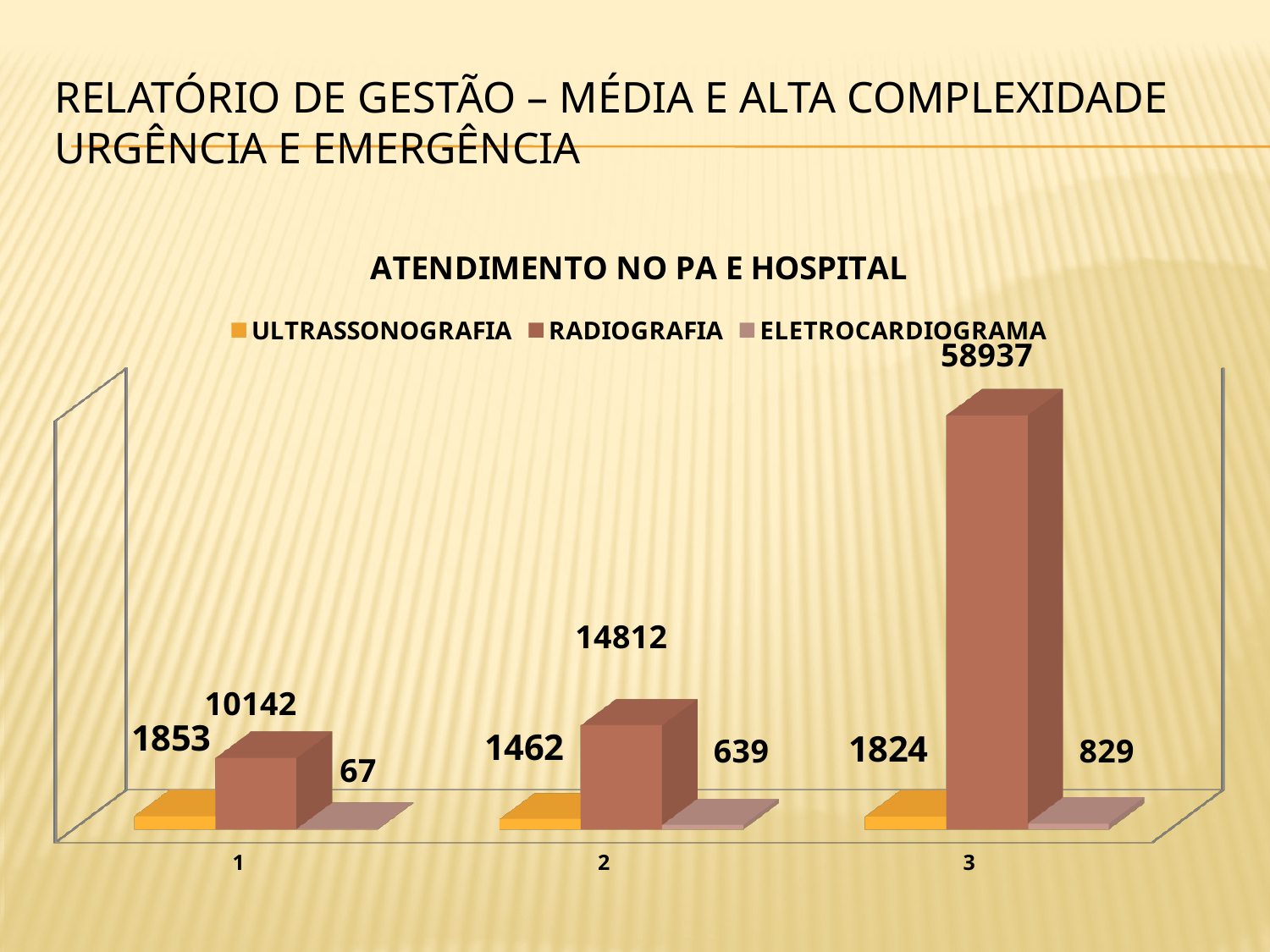
Which category has the lowest ELETROCARDIOGRAMA value? 1 What is the value of RADIOGRAFIA for category 3? 58937 What kind of chart is shown? Bar chart Which category has the highest RADIOGRAFIA value? 3 What is the title of the chart? ATENDIMENTO NO PA E HOSPITAL How many series does the legend list? 3 Do the RADIOGRAFIA values rise or fall from category 1 to category 3? Rise How many categories are shown on the x axis? 3 Which is larger, ULTRASSONOGRAFIA for category 1 or ULTRASSONOGRAFIA for category 3? Category 1 What is the value of ELETROCARDIOGRAMA for category 2? 639 What is the difference between the RADIOGRAFIA values for category 2 and category 1? 4670 What is the value of ULTRASSONOGRAFIA for category 1? 1853